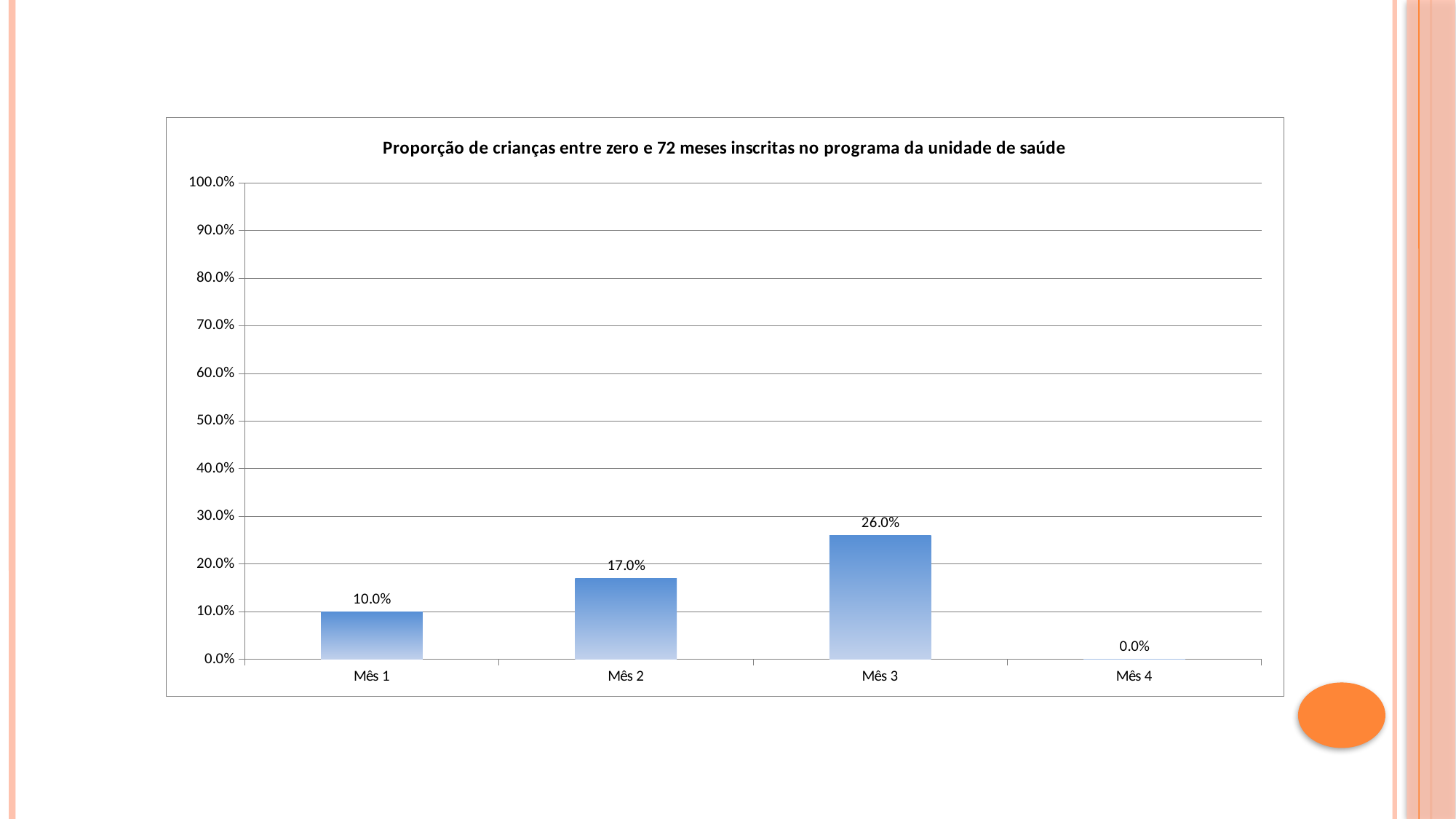
What is the value for Mês 3? 26.0% What is the title of the chart? Proporção de crianças entre zero e 72 meses inscritas no programa da unidade de saúde Is the value for Mês 3 greater or less than 30.0%? less Which month has the lowest value? Mês 4 How many months are shown on the x axis? 4 What is the value for Mês 1? 10.0% What is the value for Mês 2? 17.0% What kind of chart is shown on the slide? bar chart What is the difference between the values for Mês 3 and Mês 1? 16.0% Which month has the highest value? Mês 3 What is the value for Mês 4? 0.0% Which is larger, the value for Mês 2 or the value for Mês 1? Mês 2